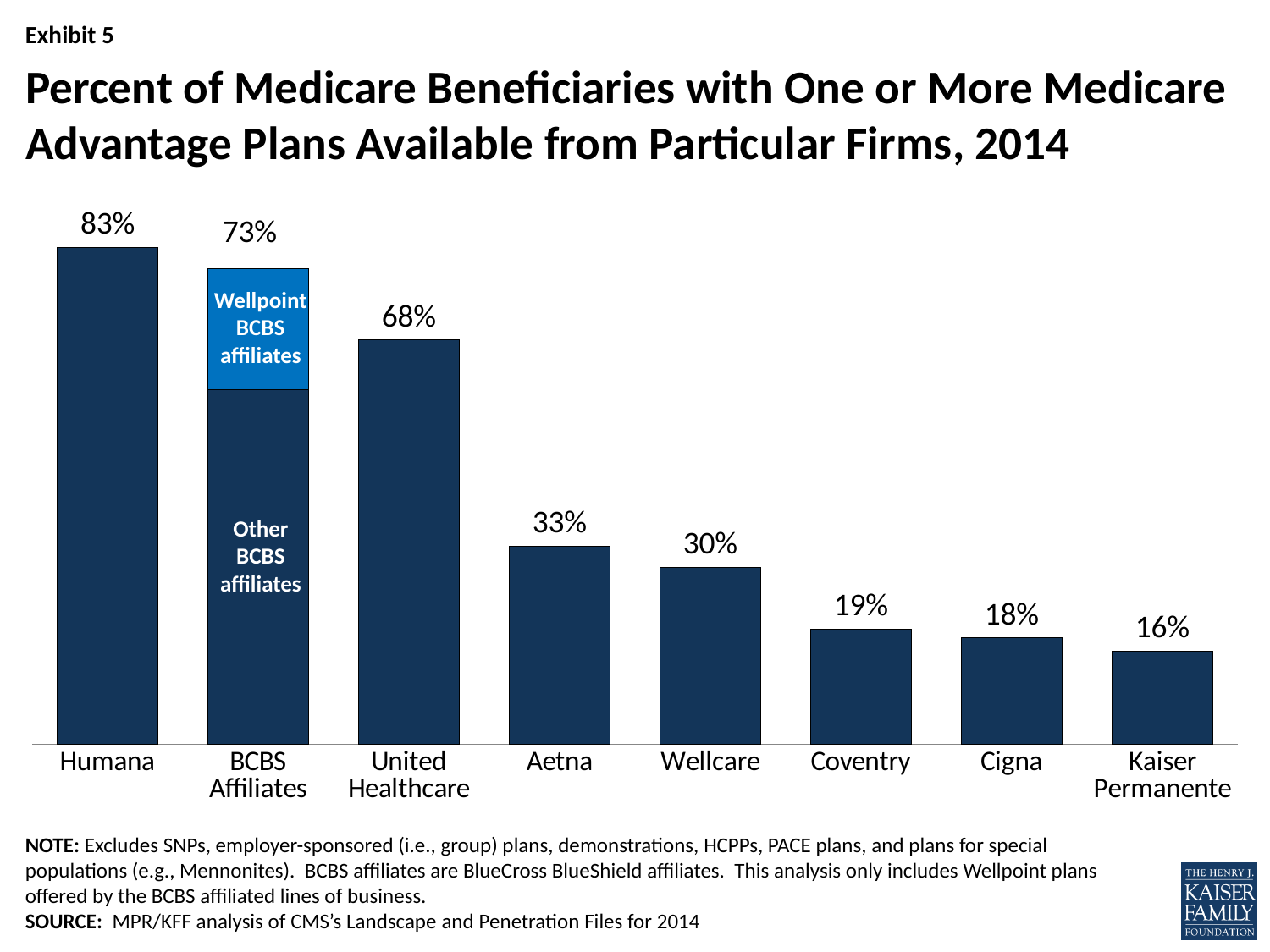
What percent of Medicare beneficiaries have one or more Medicare Advantage plans available from Humana? 83% What are the two segments of the BCBS Affiliates bar labelled? Wellpoint BCBS affiliates and Other BCBS affiliates What is the value shown for United Healthcare? 68% How many firms are shown on the chart? 8 What kind of chart is shown on the slide? Bar chart What is the difference in percentage points between Aetna and Wellcare? 3 Which firm has the lowest percent of Medicare beneficiaries with one or more plans available? Kaiser Permanente Which firm has the highest percent of Medicare beneficiaries with one or more plans available? Humana Which has a higher value, Coventry or Cigna? Coventry What is the difference in percentage points between Humana and United Healthcare? 15 What is the total value shown for BCBS Affiliates? 73% What is the value shown for Kaiser Permanente? 16%